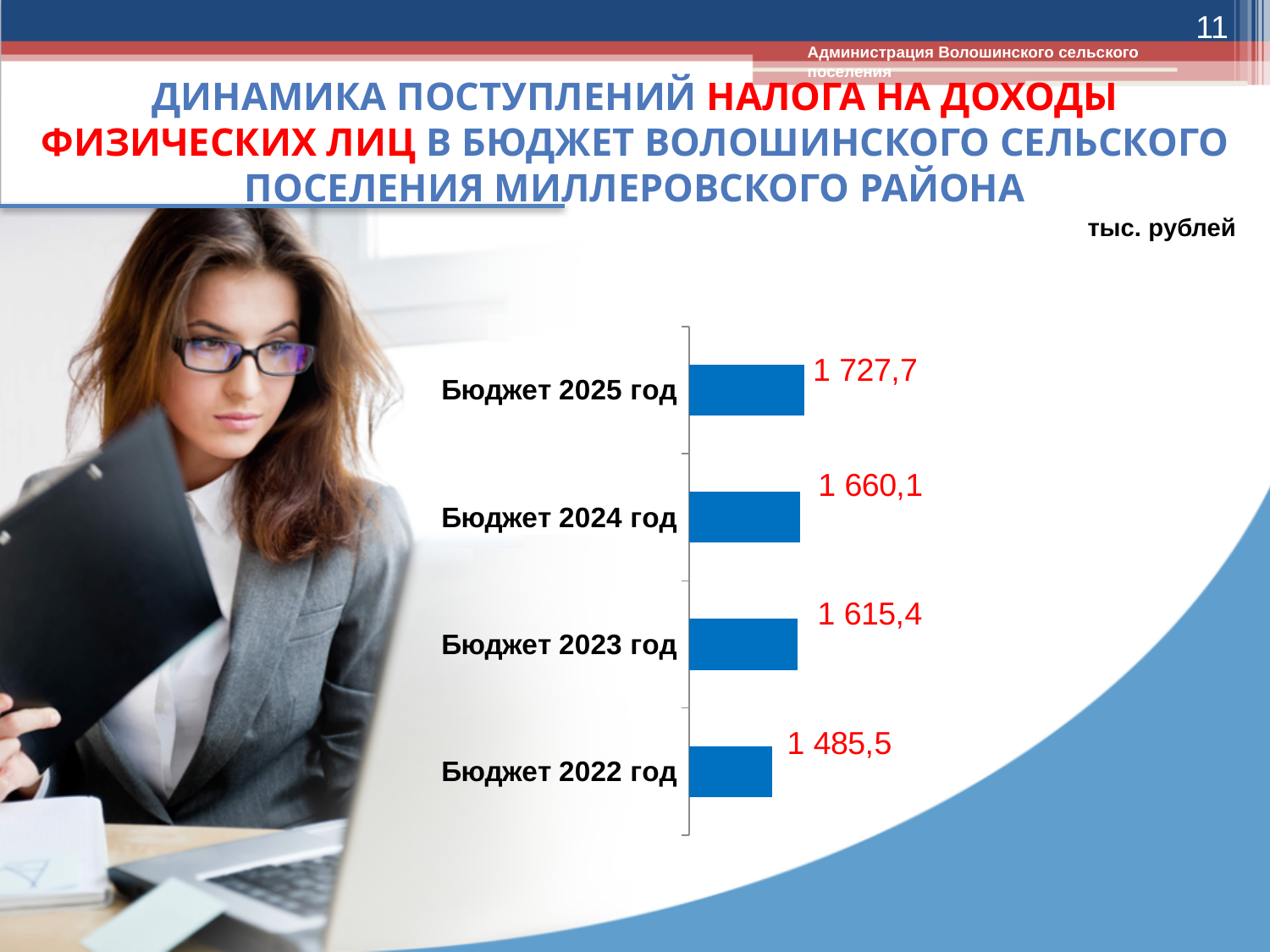
What is the value for Бюджет 2025 год? 1 727,7 Do the values rise or fall from Бюджет 2022 год to Бюджет 2025 год? Rise How many categories are shown in the chart? 4 Which category has the highest value? Бюджет 2025 год Which category has the lowest value? Бюджет 2022 год Which is larger, the value for Бюджет 2024 год or Бюджет 2023 год? Бюджет 2024 год What is the value for Бюджет 2023 год? 1 615,4 What is the value for Бюджет 2022 год? 1 485,5 What is the difference between the values for Бюджет 2025 год and Бюджет 2024 год? 67,6 What is the value for Бюджет 2024 год? 1 660,1 What is the difference between the values for Бюджет 2023 год and Бюджет 2022 год? 129,9 What kind of chart is shown on the slide? Bar chart